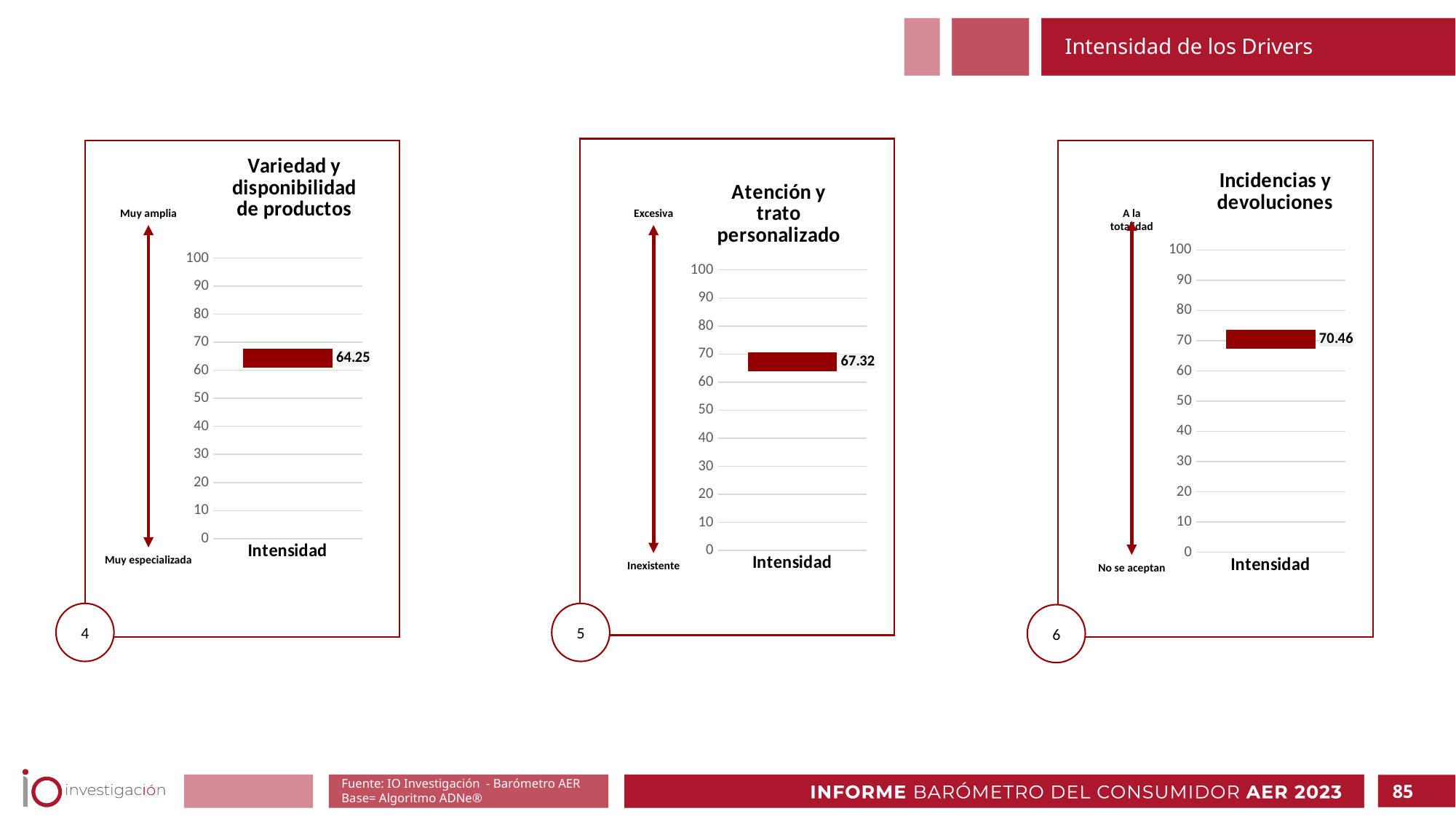
Which of the three charts on the slide shows the lowest Intensidad value? Variedad y disponibilidad de productos In the chart titled 'Incidencias y devoluciones', is the Intensidad value greater or less than 70? greater In the chart titled 'Variedad y disponibilidad de productos', is the Intensidad value greater or less than 70? less In the chart titled 'Incidencias y devoluciones', what is the value of the Intensidad bar? 70.46 In the chart titled 'Variedad y disponibilidad de productos', what is the value of the Intensidad bar? 64.25 In the chart titled 'Atención y trato personalizado', what is the value of the Intensidad bar? 67.32 What kind of chart is used in the 'Atención y trato personalizado' panel? Bar chart Which of the three charts on the slide shows the highest Intensidad value? Incidencias y devoluciones What is the difference between the Intensidad value in the 'Incidencias y devoluciones' chart and the one in the 'Variedad y disponibilidad de productos' chart? 6.21 Which is larger: the Intensidad value in the 'Atención y trato personalizado' chart or in the 'Variedad y disponibilidad de productos' chart? Atención y trato personalizado What is the maximum value shown on the vertical axis of the 'Variedad y disponibilidad de productos' chart? 100 How many bars are plotted in the chart titled 'Incidencias y devoluciones'? 1